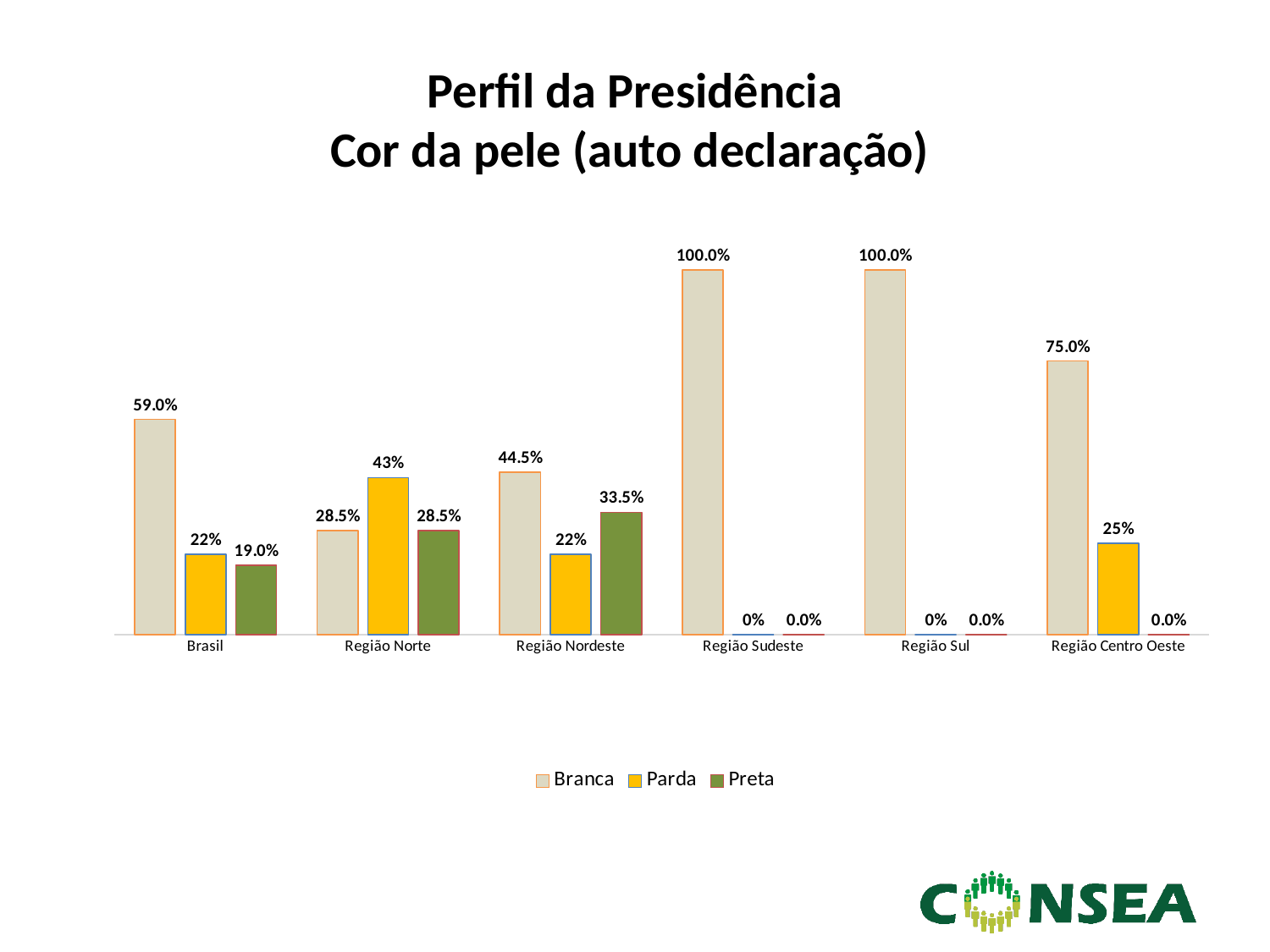
What is the value for Preta in Região Nordeste? 33.5% What is the value for Branca in Brasil? 59.0% Which is larger in Região Nordeste, Parda or Preta? Preta What is the value for Parda in Região Norte? 43% What is the value for Preta in Região Sul? 0.0% How many categories are shown on the x axis? 6 What is the difference between the Branca and Parda values in Brasil? 37.0% What kind of chart is shown on the slide? Bar chart Which category has the highest value for Parda? Região Norte Which category has the lowest value for Branca? Região Norte What is the value for Branca in Região Centro Oeste? 75.0% How many series does the legend list? 3